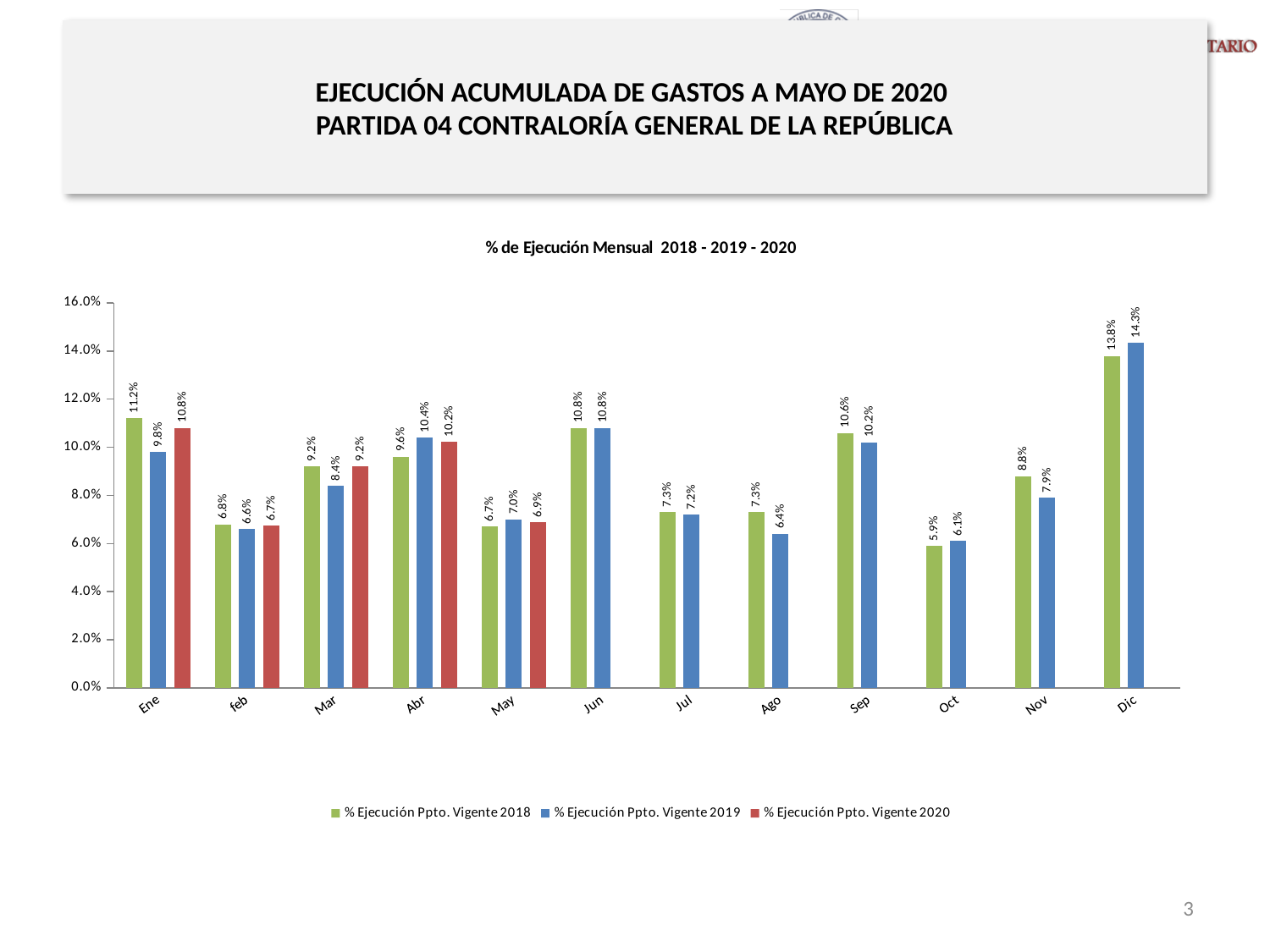
Which is larger for Mar: the 2018 value or the 2019 value? 2018 How many months are shown on the x axis? 12 What is the % Ejecución Ppto. Vigente 2020 value for Abr? 10.2% Which month has the highest % Ejecución Ppto. Vigente 2019 value? Dic How many series does the legend list? 3 Which colour represents % Ejecución Ppto. Vigente 2020 in the chart? red What kind of chart is shown on the slide? bar chart What is the difference between the 2018 and 2019 values for Ago? 0.9% What is the % Ejecución Ppto. Vigente 2019 value for Dic? 14.3% Is the % Ejecución Ppto. Vigente 2018 value for Dic greater or less than 12.0%? greater Which month has the lowest % Ejecución Ppto. Vigente 2018 value? Oct What is the % Ejecución Ppto. Vigente 2018 value for Ene? 11.2%